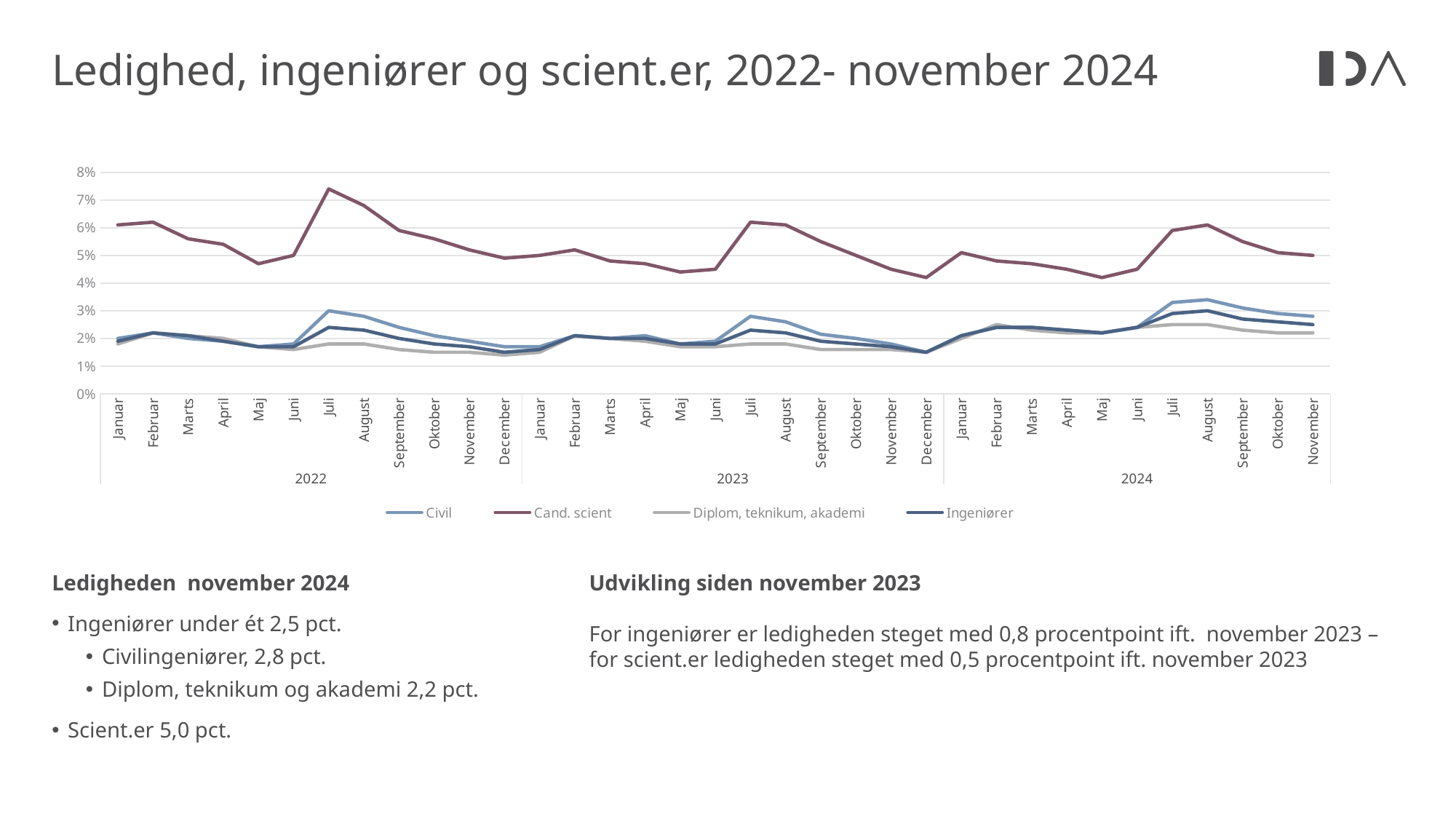
Is the value for Cand. scient in December 2023 greater or less than 5%? less According to the slide, what is the unemployment rate for Scient.er in November 2024? 5,0 pct. Which is larger in Juli 2023, the value for Cand. scient or the value for Civil? Cand. scient In which month and year does the Cand. scient series reach its highest value? Juli 2022 Does the Cand. scient series rise or fall from Juli 2022 to December 2022? fall How many series does the legend list? 4 Is the value for Diplom, teknikum, akademi in Maj 2022 greater or less than 2%? less Is the value for Civil in August 2024 greater or less than 3%? greater According to the slide, what is the unemployment rate for Civilingeniører in November 2024? 2,8 pct. What kind of chart is shown on the slide? line chart Which series has the highest values throughout the chart? Cand. scient